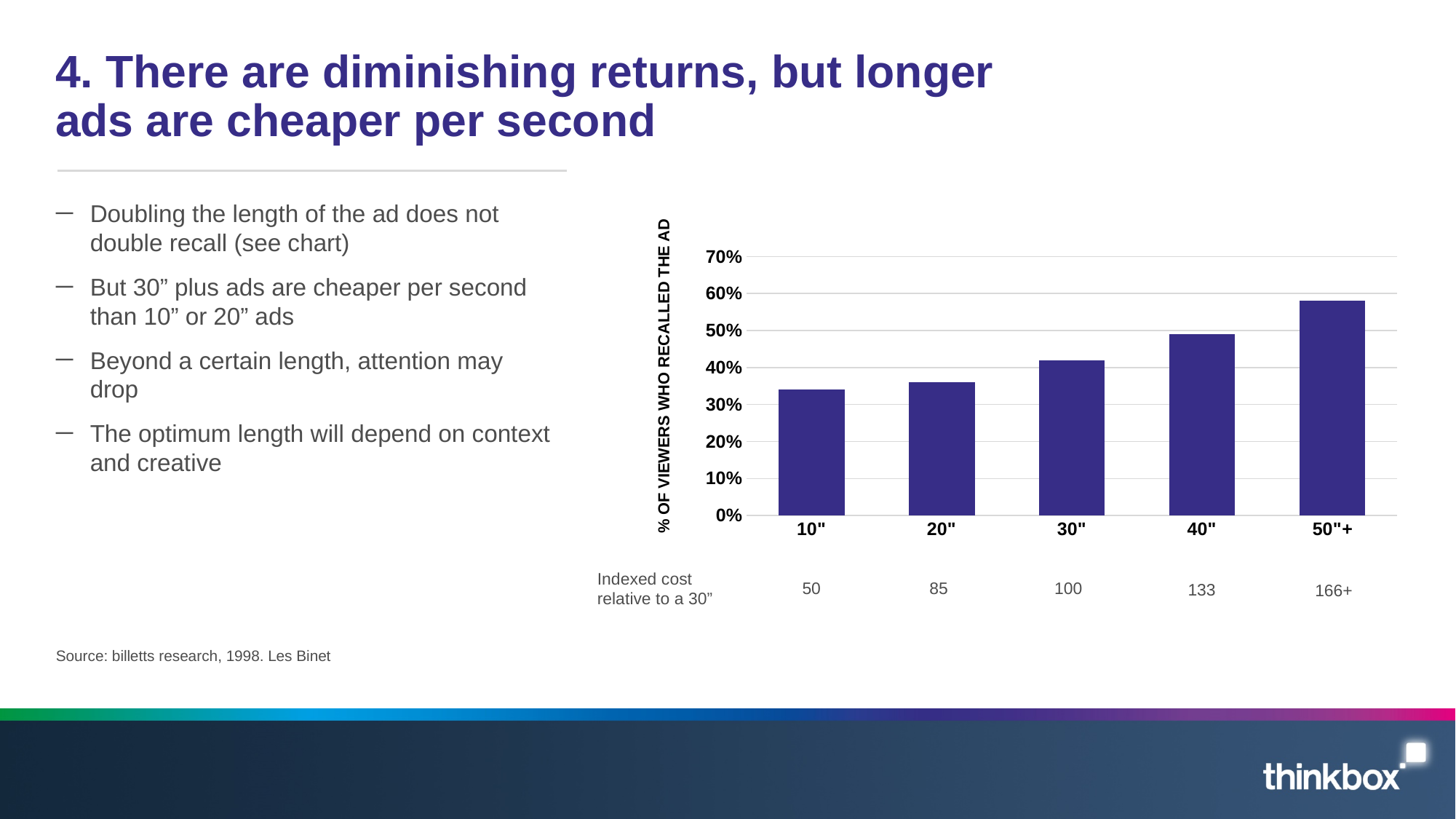
What kind of chart is shown on the slide? bar chart What is the indexed cost relative to a 30" shown beneath the 40" bar? 133 Which has a higher recall percentage, 30" or 50"+? 50"+ How many ad-length categories are plotted on the chart? 5 Do the values rise or fall as ad length increases along the x axis? rise Is the value for 20" greater or less than 30%? greater Is the value for 10" greater or less than 40%? less Is the value for 30" greater or less than 40%? greater Which ad length has the highest percentage of viewers who recalled the ad? 50"+ What is the label on the vertical axis of the chart? % OF VIEWERS WHO RECALLED THE AD